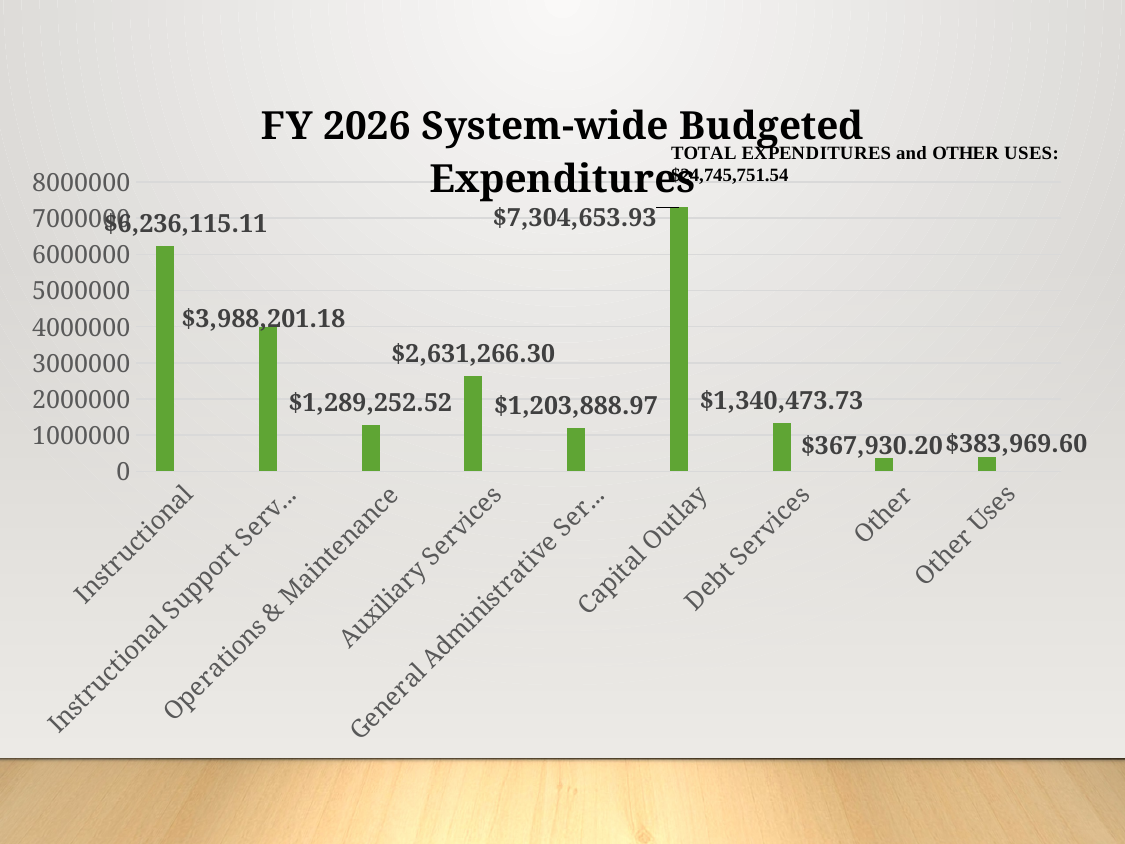
What type of chart is shown on the slide? Bar chart What is the budgeted value for Instructional? $6,236,115.11 How many categories are shown on the x axis? 9 What is the budgeted value for Capital Outlay? $7,304,653.93 What is the budgeted value for Debt Services? $1,340,473.73 What is the difference between the Capital Outlay and Instructional values? $1,068,538.82 Which category has the lowest budgeted expenditure? Other Which category has the highest budgeted expenditure? Capital Outlay Which is larger, the value for Debt Services or the value for Operations & Maintenance? Debt Services Is the value for Auxiliary Services greater or less than 2000000? greater What is the budgeted value for Other Uses? $383,969.60 What is the budgeted value for Auxiliary Services? $2,631,266.30